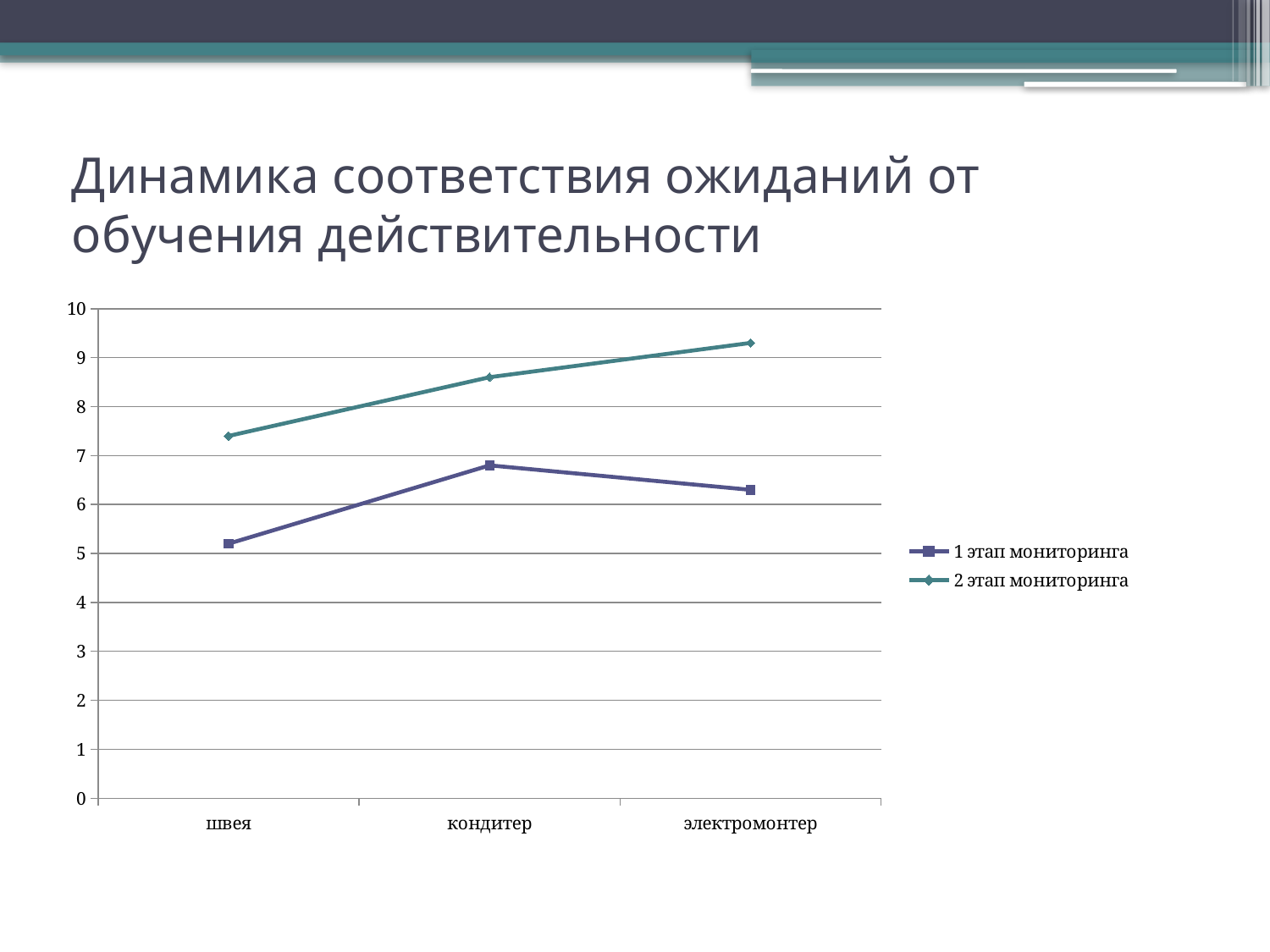
Which category has the highest value for the series "1 этап мониторинга"? кондитер Is the value for "электромонтер" in the series "2 этап мониторинга" greater or less than 9? greater How many categories are shown on the x axis? 3 How many series does the legend list? 2 What kind of chart is shown on the slide? line chart Which category has the lowest value for the series "1 этап мониторинга"? швея Do the values of the series "2 этап мониторинга" rise or fall from "швея" to "электромонтер"? rise Is the value for "кондитер" in the series "2 этап мониторинга" greater or less than 8? greater Is the value for "швея" in the series "1 этап мониторинга" greater or less than 6? less For "электромонтер", which series has the larger value: "1 этап мониторинга" or "2 этап мониторинга"? 2 этап мониторинга What is the title of the slide? Динамика соответствия ожиданий от обучения действительности Which category has the highest value for the series "2 этап мониторинга"? электромонтер